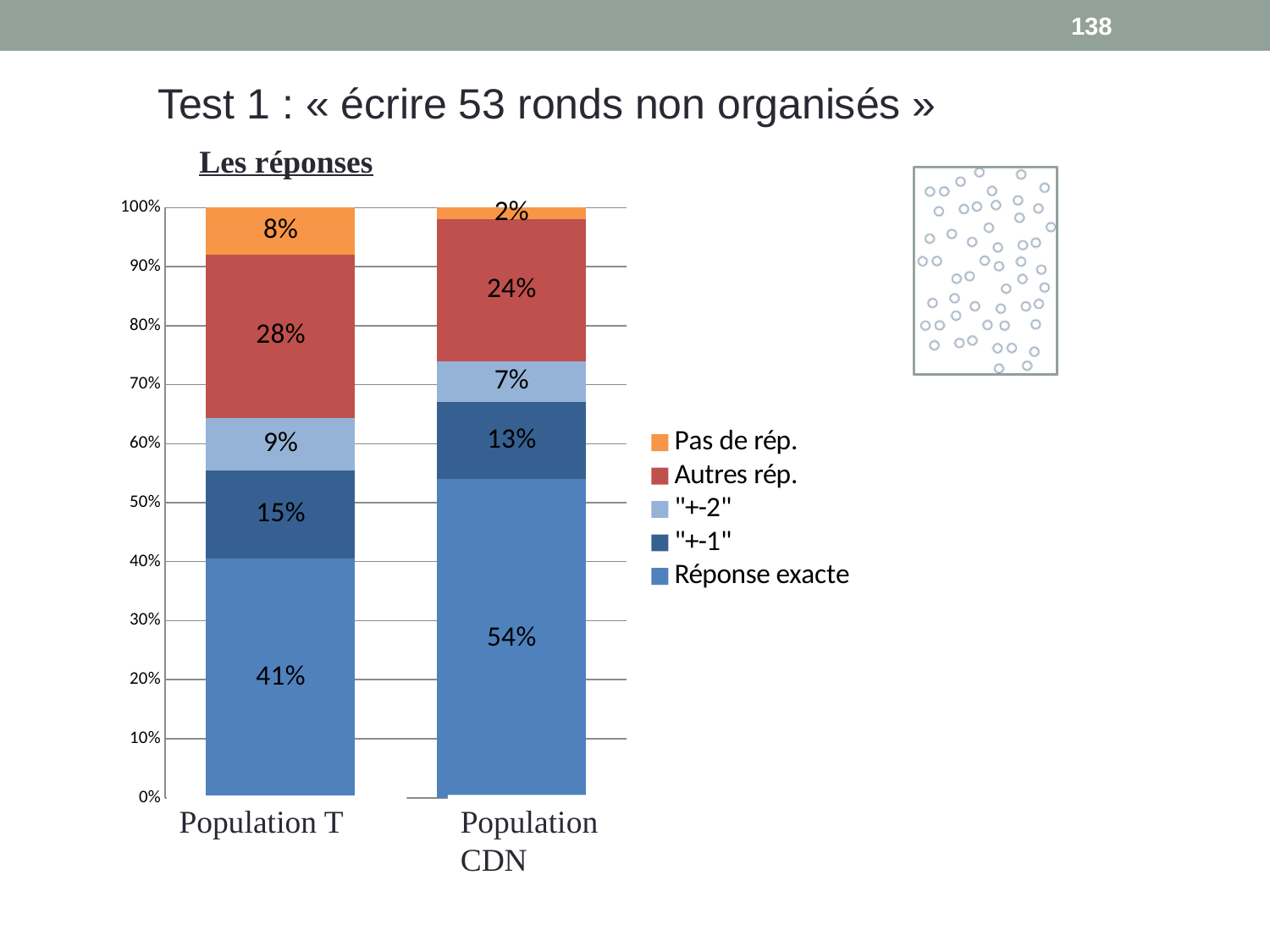
Which series is shown in orange in the legend? Pas de rép. What is the value of "Autres rép." for Population CDN? 24% How many categories (populations) are shown on the x axis? 2 What is the value of "+-1" for Population CDN? 13% What is the difference between the "Autres rép." values for Population T and Population CDN? 4% Which population has the larger share of "Réponse exacte"? Population CDN What is the value of "Réponse exacte" for Population T? 41% What is the value of "Réponse exacte" for Population CDN? 54% What is the difference between the "Réponse exacte" values for Population CDN and Population T? 13% What type of chart is shown on the slide? stacked bar chart How many series does the legend list? 5 What is the value of "Pas de rép." for Population T? 8%